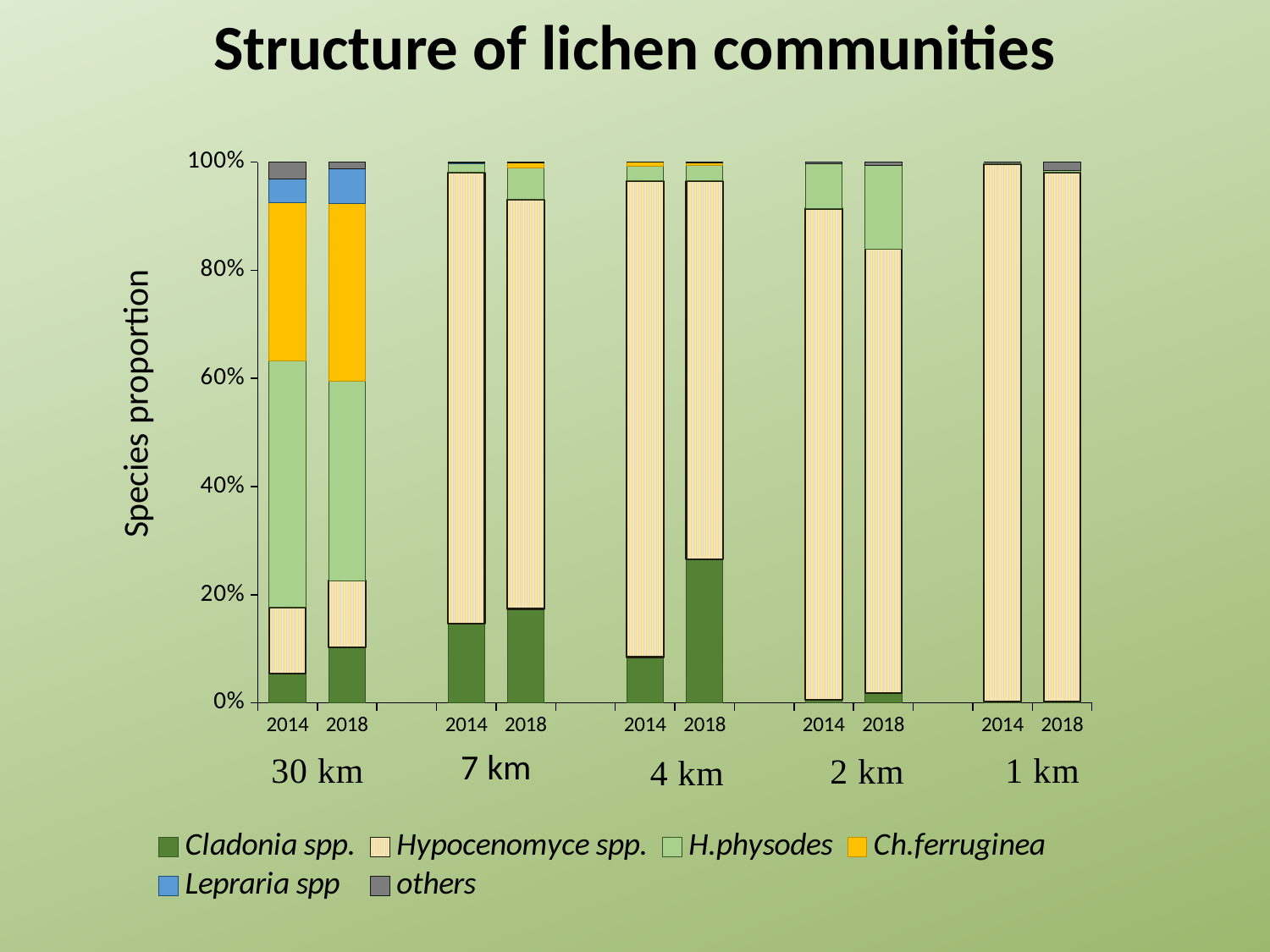
Is the Cladonia spp. proportion for 4 km in 2018 greater or less than 20%? greater Is the Cladonia spp. proportion for 30 km in 2014 greater or less than 20%? less What is the title of the chart? Structure of lichen communities How many bars are plotted in the chart? 10 What is the label of the y axis? Species proportion At 4 km, is the Cladonia spp. proportion larger in 2014 or in 2018? 2018 How many series does the legend list? 6 Is the Hypocenomyce spp. proportion for 1 km in 2014 greater or less than 80%? greater What kind of chart is shown on the slide? stacked bar chart In 2018, which distance has the largest Cladonia spp. proportion? 4 km